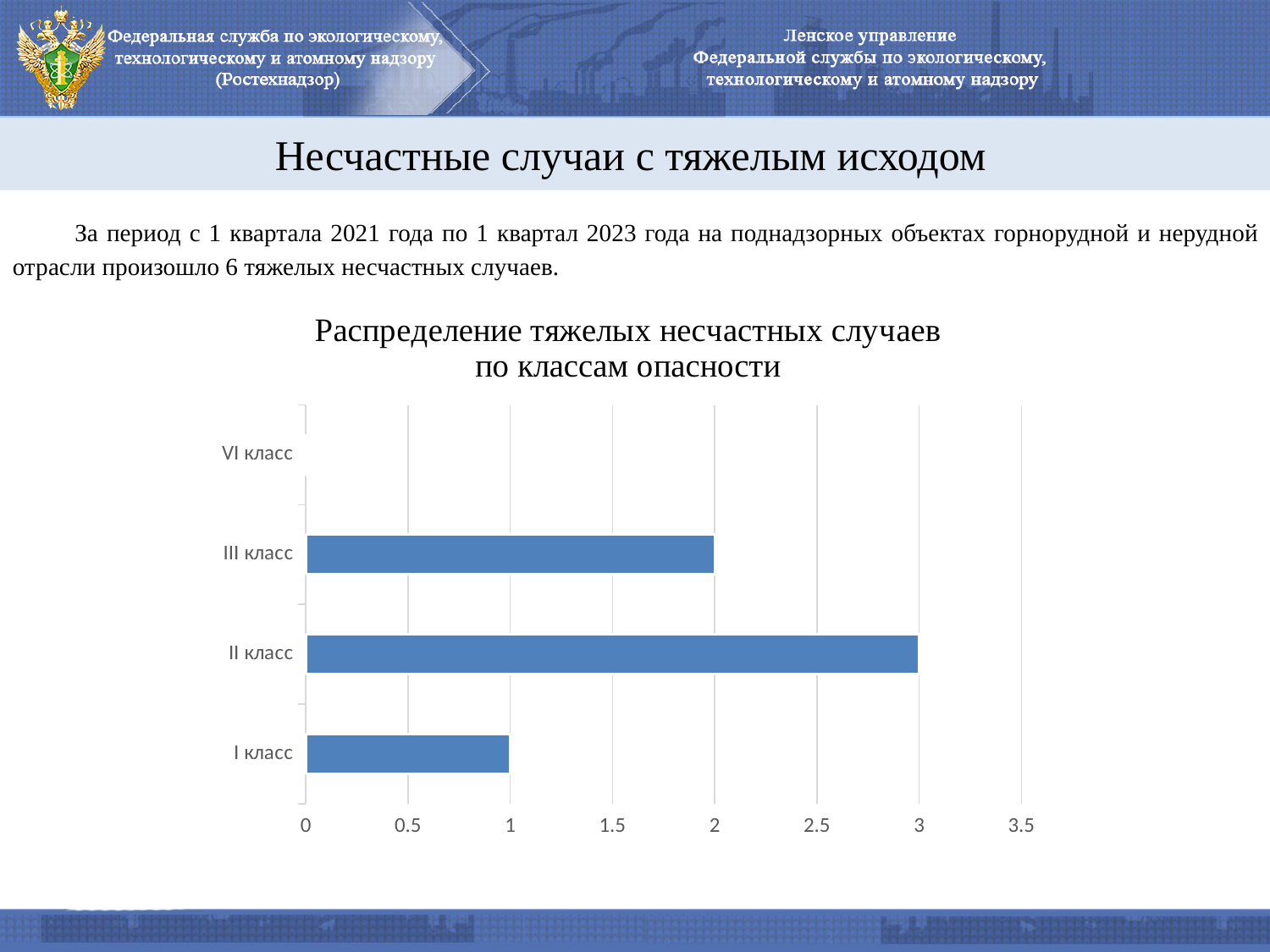
What kind of chart is shown on the slide? bar chart Which hazard class has the lowest value in the chart? VI класс Is the value for II класс greater or less than 2.5? greater What is the value for III класс in the chart? 2 What is the difference between the values for II класс and I класс? 2 Which hazard class has the highest number of severe accidents? II класс How many hazard classes are shown on the chart's axis? 4 What is the value for I класс in the chart? 1 What is the value for II класс in the chart? 3 Which is larger, the value for III класс or the value for I класс? III класс What is the difference between the values for II класс and III класс? 1 What is the title of the chart? Распределение тяжелых несчастных случаев по классам опасности